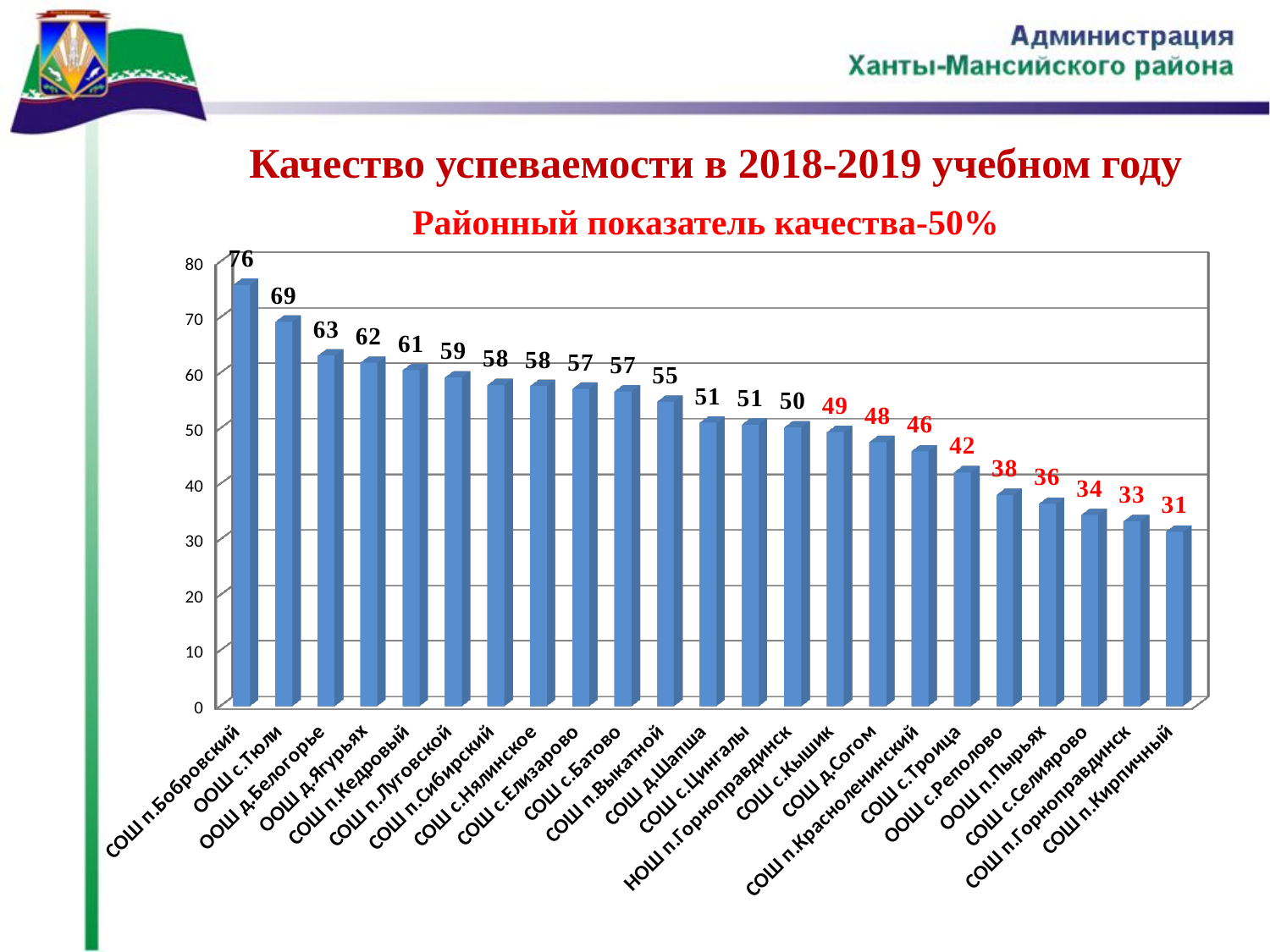
Which school has the lowest value? СОШ п.Кирпичный What kind of chart is shown on the slide? bar chart How many schools are shown on the chart? 23 What district quality indicator is stated in the chart subtitle? 50% Which school has the highest value? СОШ п.Бобровский Is the value for ООШ с.Реполово greater or less than 50? less Which is larger, the value for СОШ п.Кедровый or the value for СОШ д.Согом? СОШ п.Кедровый What is the value for СОШ п.Бобровский? 76 What is the difference between the values for ООШ с.Тюли and СОШ п.Кирпичный? 38 What is the value for СОШ с.Троица? 42 Do the values rise or fall from left to right along the x axis? fall What is the value for НОШ п.Горноправдинск? 50